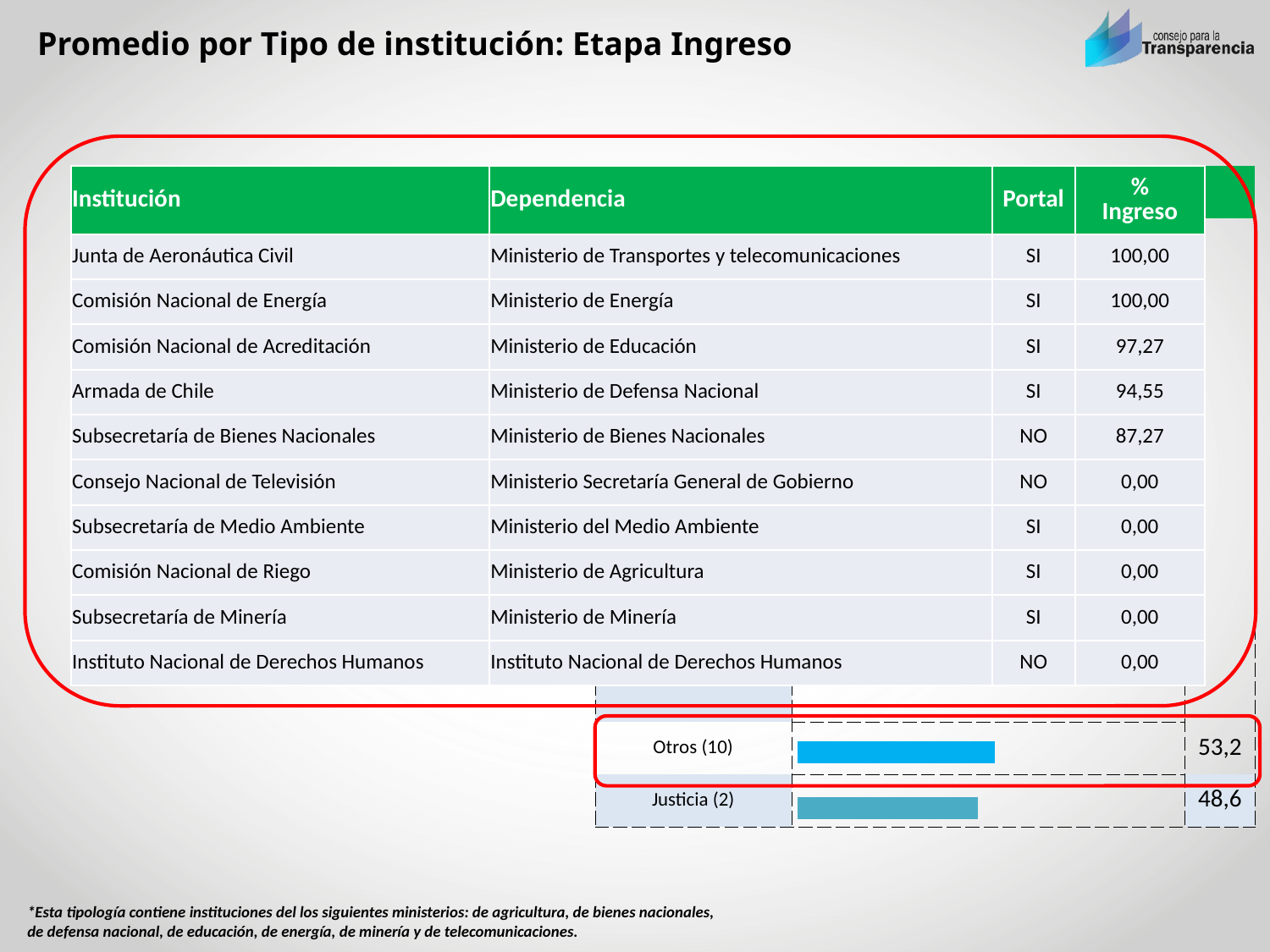
What is the difference between the values for Otros (10) and Justicia (2) in the bar chart? 4,6 Are the bars in the chart at the bottom of the slide horizontal or vertical? Horizontal What is the value shown for Otros (10) in the bar chart? 53,2 What kind of chart is shown at the bottom of the slide? Bar chart Of the two labelled bars in the chart, which has the lower value? Justicia (2) Of the two labelled bars in the chart, which has the higher value? Otros (10) What is the value shown for Justicia (2) in the bar chart? 48,6 Which bar in the chart is highlighted with a red outline? Otros (10) In the bar chart, which category has the higher value, Otros (10) or Justicia (2)? Otros (10)